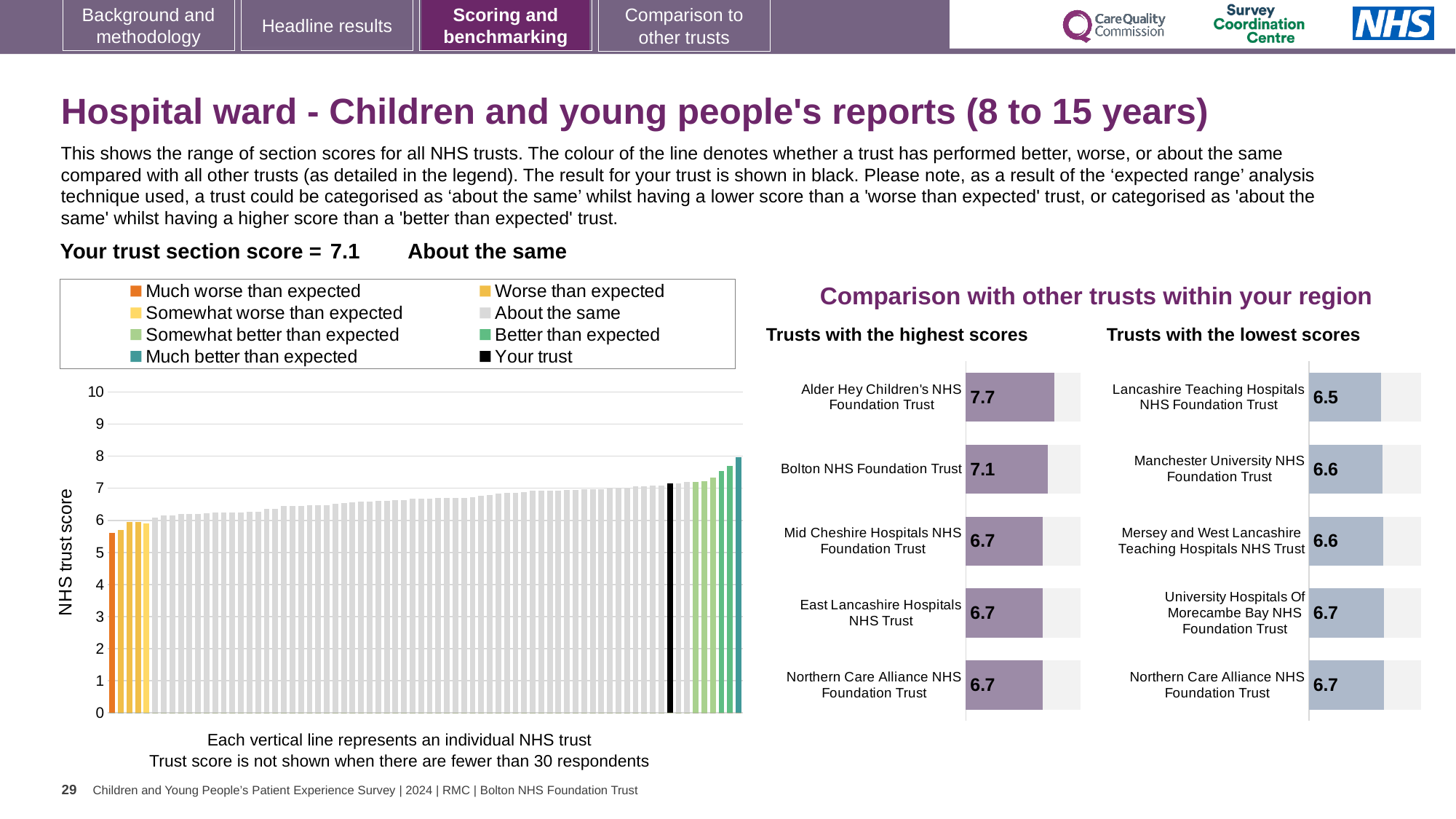
In the 'Trusts with the highest scores' chart, which trust has the highest score? Alder Hey Children's NHS Foundation Trust In the 'Trusts with the highest scores' chart, what is the score for Alder Hey Children's NHS Foundation Trust? 7.7 In the 'Trusts with the highest scores' chart, how many trusts are listed? 5 How many entries does the legend above the large chart on the left list? 8 In the 'Trusts with the lowest scores' chart, which trust has the lowest score? Lancashire Teaching Hospitals NHS Foundation Trust In the large chart on the left showing all NHS trusts, is the value of the leftmost (orange) bar greater or less than 6? less In the large chart on the left showing all NHS trusts, is the value of the black bar (your trust) greater or less than 6? greater In the 'Trusts with the lowest scores' chart, what is the score for Lancashire Teaching Hospitals NHS Foundation Trust? 6.5 In the 'Trusts with the lowest scores' chart, what is the score for Manchester University NHS Foundation Trust? 6.6 In the 'Trusts with the highest scores' chart, what is the score for Bolton NHS Foundation Trust? 7.1 In the 'Trusts with the highest scores' chart, what is the difference between the scores of Alder Hey Children's NHS Foundation Trust and Bolton NHS Foundation Trust? 0.6 What kind of chart is the 'Trusts with the lowest scores' chart? Bar chart